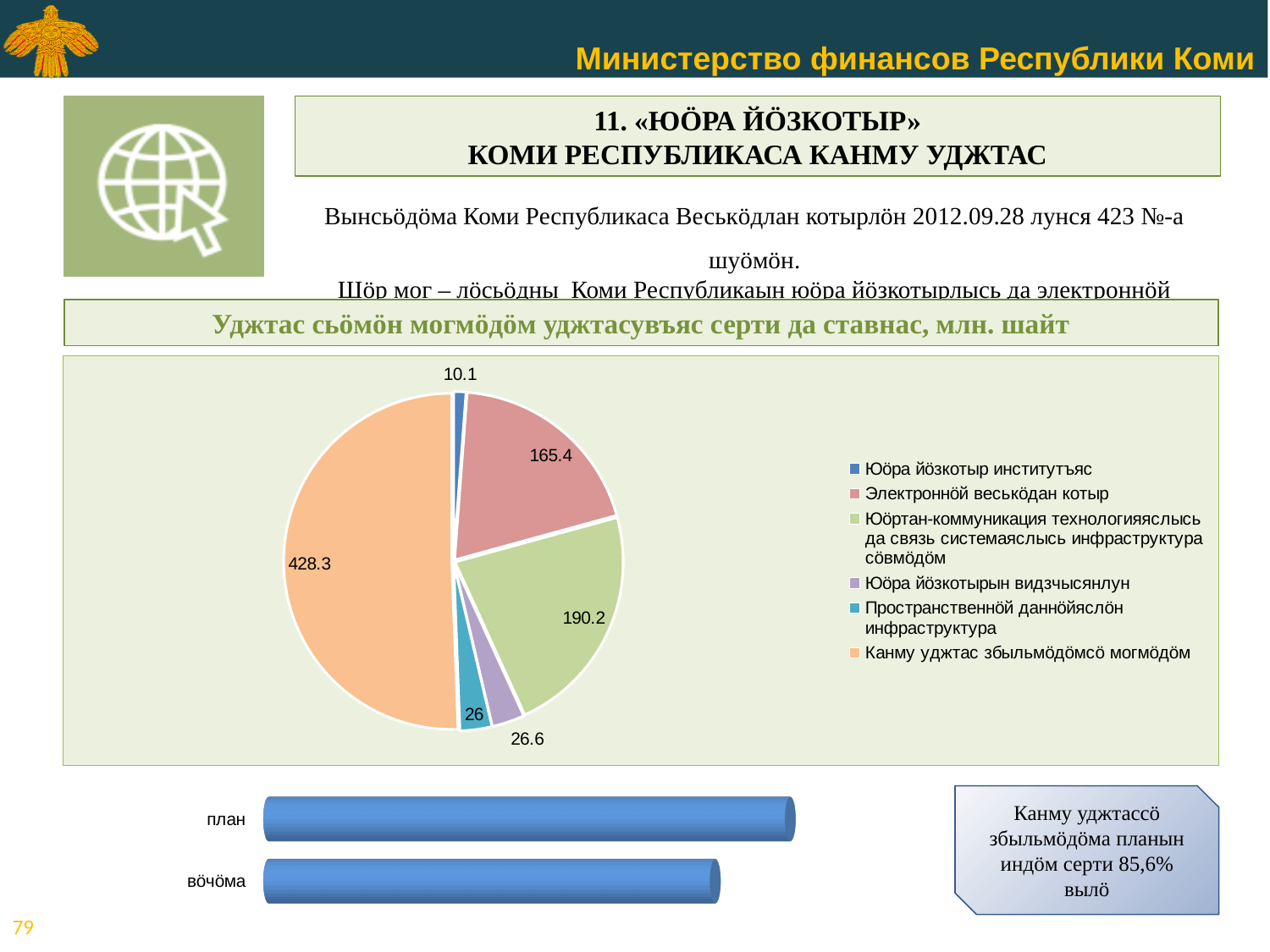
In the pie chart, what is the value for Электроннöй веськöдан котыр? 165.4 How many entries does the pie chart's legend list? 6 What type of chart is shown in the lower part of the slide with the categories план and вöчöма? bar chart In the pie chart, which category has the smallest slice? Юöра йöзкотыр институтъяс In the pie chart, what is the value for Канму уджтас збыльмöдöмсö могмöдöм? 428.3 In the pie chart, what is the value for Юöра йöзкотыр институтъяс? 10.1 In the pie chart, which is larger: Юöра йöзкотырын видзчысянлун or Пространственнöй даннöйяслöн инфраструктура? Юöра йöзкотырын видзчысянлун How many slices does the pie chart have? 6 In the pie chart, what is the difference between the values for Юöртан-коммуникация технологияяслысь да связь системаяслысь инфраструктура сöвмöдöм and Электроннöй веськöдан котыр? 24.8 In the bar chart at the bottom of the slide, which bar is longer: план or вöчöма? план In the pie chart, which category has the largest slice? Канму уджтас збыльмöдöмсö могмöдöм In the pie chart, what is the value for Пространственнöй даннöйяслöн инфраструктура? 26